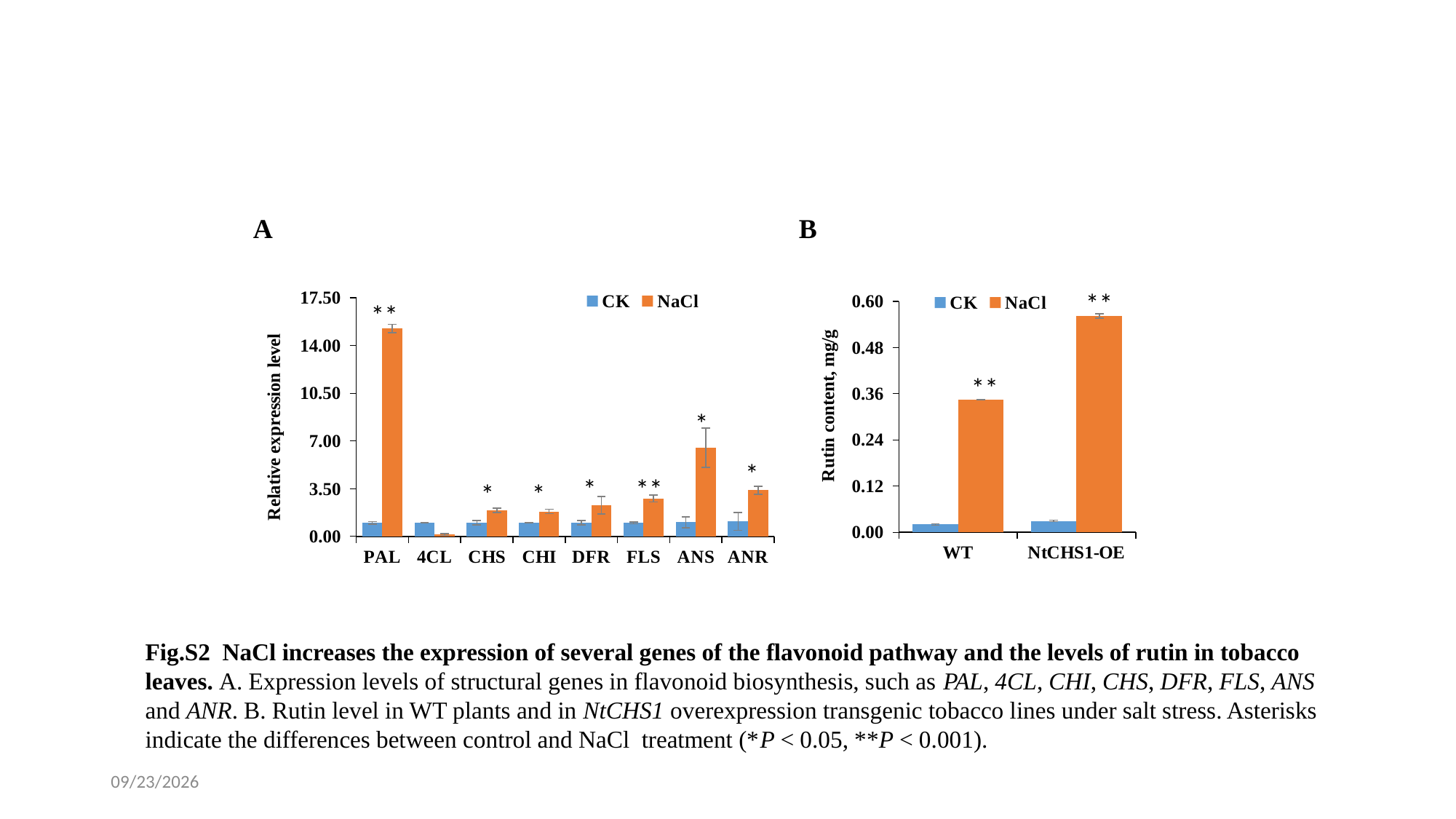
In chart B (right), is the NaCl value for NtCHS1-OE greater or less than 0.48? greater How many series does the legend of chart A (left) list? 2 What kind of chart is chart B (right)? bar chart In chart A (left), is the NaCl value for 4CL greater or less than 3.50? less How many genes are shown on the x axis of chart A (left)? 8 In chart A (left), is the NaCl value for ANS greater or less than 3.50? greater In chart A (left), which gene has the highest NaCl expression level? PAL In chart A (left), which is larger, the NaCl value for ANS or the NaCl value for CHS? ANS In chart A (left), which gene has the lowest NaCl expression level? 4CL In chart B (right), which is larger, the NaCl value for WT or the NaCl value for NtCHS1-OE? NtCHS1-OE What is the y-axis label of chart B (right)? Rutin content, mg/g